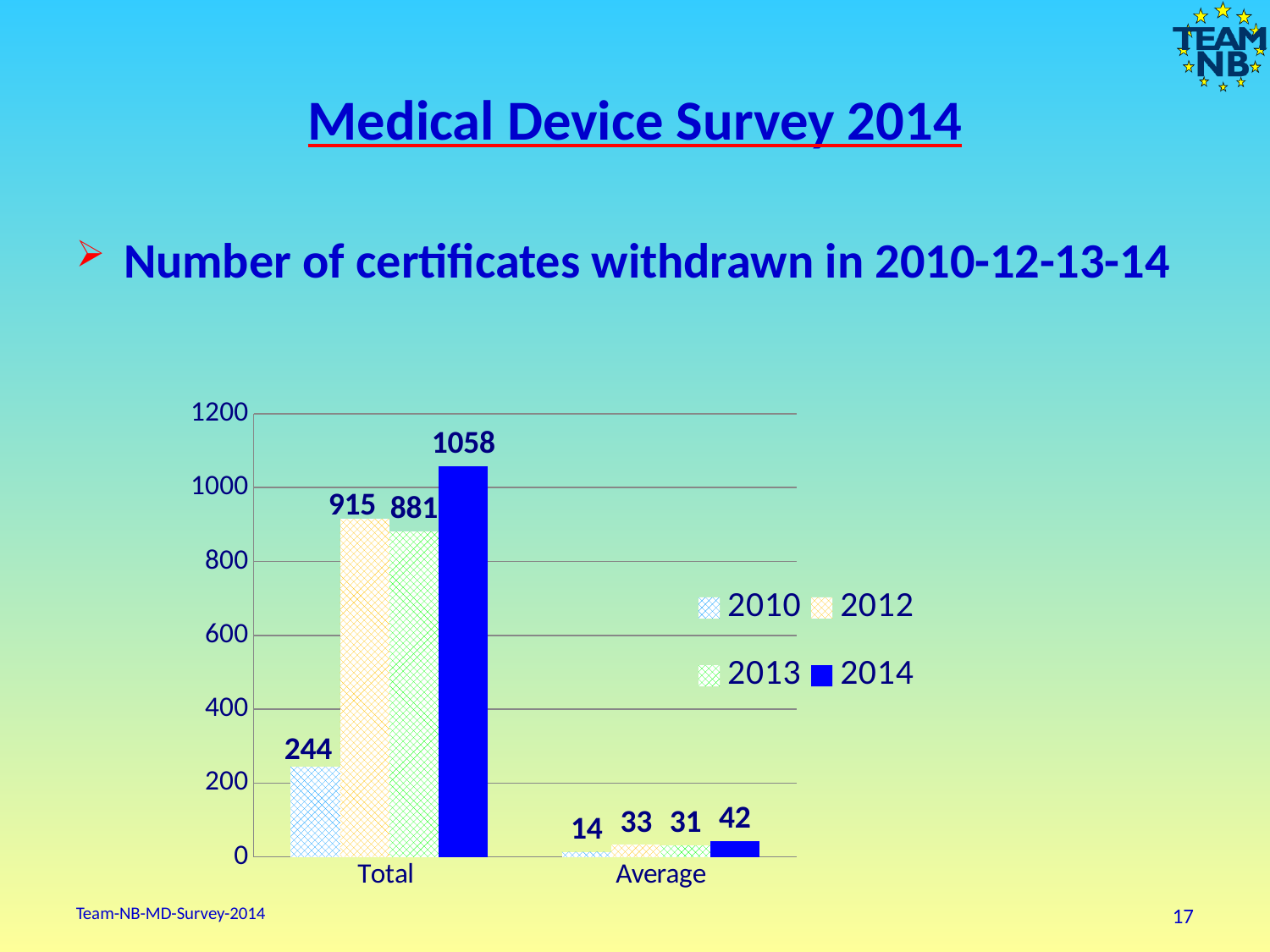
What is the Average value for 2012? 33 Which is larger, the Total value for 2012 or for 2013? 2012 What kind of chart is shown on the slide? bar chart What is the Total value for 2014? 1058 What is the Total value for 2010? 244 Which year has the lowest Average value? 2010 What is the difference between the Average values for 2014 and 2010? 28 Which year has the highest Total value? 2014 What is the difference between the Total values for 2014 and 2012? 143 How many categories are shown on the x axis? 2 How many series does the legend list? 4 What is the Average value for 2013? 31